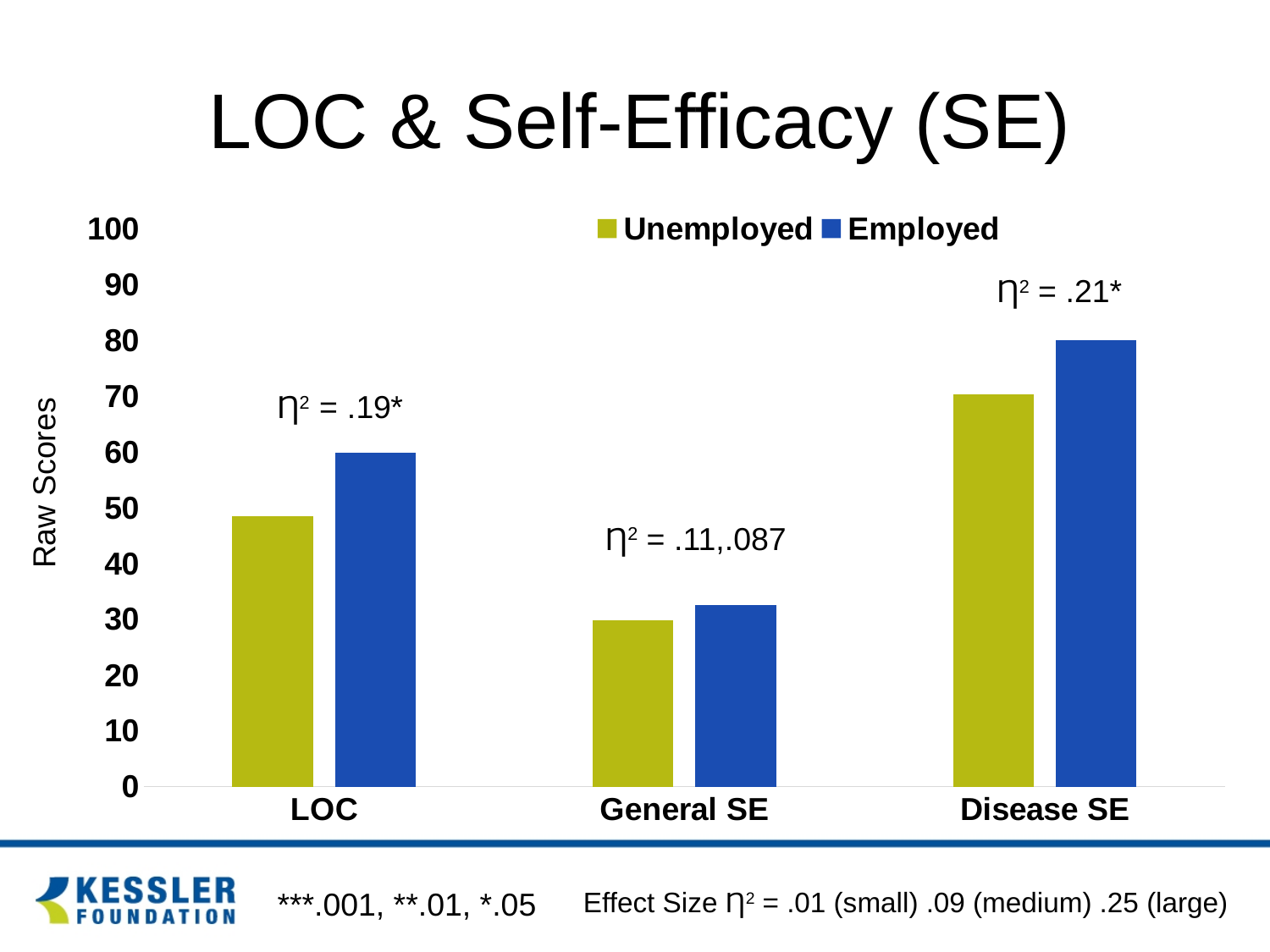
Is the Unemployed value for Disease SE greater or less than 60? greater For Disease SE, which is larger, the Unemployed or the Employed bar? Employed Which category has the highest Employed bar? Disease SE What kind of chart is shown on the slide? bar chart Is the Employed value for LOC greater or less than 50? greater Which colour represents the Employed series? blue Which category has the lowest Unemployed bar? General SE How many series does the legend list? 2 Is the Employed value for General SE greater or less than 40? less How many categories are shown on the x axis? 3 What is the y-axis label of the chart? Raw Scores